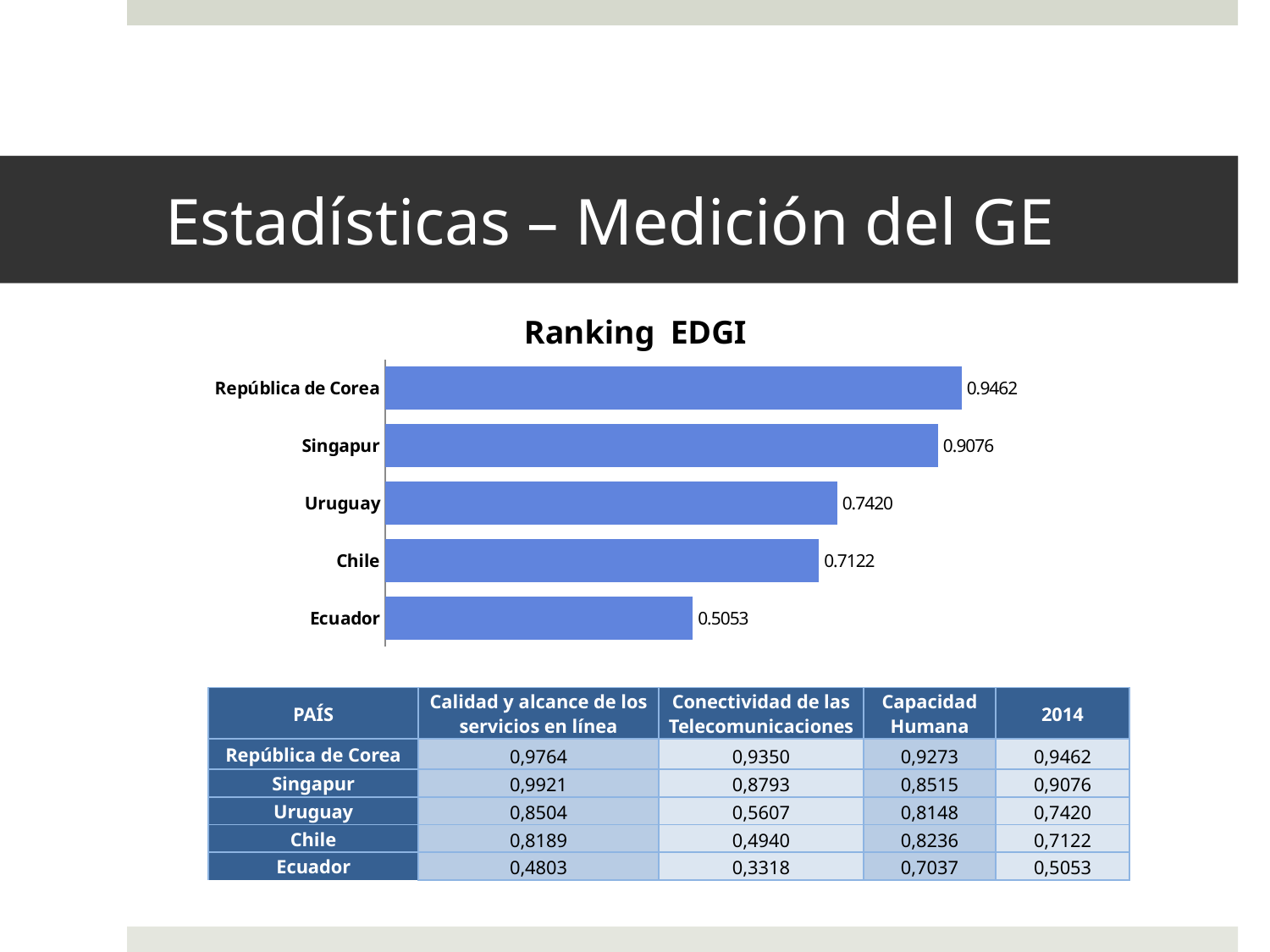
Which country has the highest value in the Ranking EDGI chart? República de Corea What is the value shown for Uruguay in the Ranking EDGI chart? 0.7420 What type of chart is the Ranking EDGI chart? Bar chart What is the title of the chart on the slide? Ranking EDGI How many countries are shown in the Ranking EDGI chart? 5 What is the value shown for Ecuador in the Ranking EDGI chart? 0.5053 In the Ranking EDGI chart, which has a larger value, Singapur or Uruguay? Singapur What is the value shown for República de Corea in the Ranking EDGI chart? 0.9462 What is the difference between the values for República de Corea and Singapur in the Ranking EDGI chart? 0.0386 Which country has the lowest value in the Ranking EDGI chart? Ecuador In the Ranking EDGI chart, which has a larger value, Chile or Ecuador? Chile What is the difference between the values for Uruguay and Chile in the Ranking EDGI chart? 0.0298